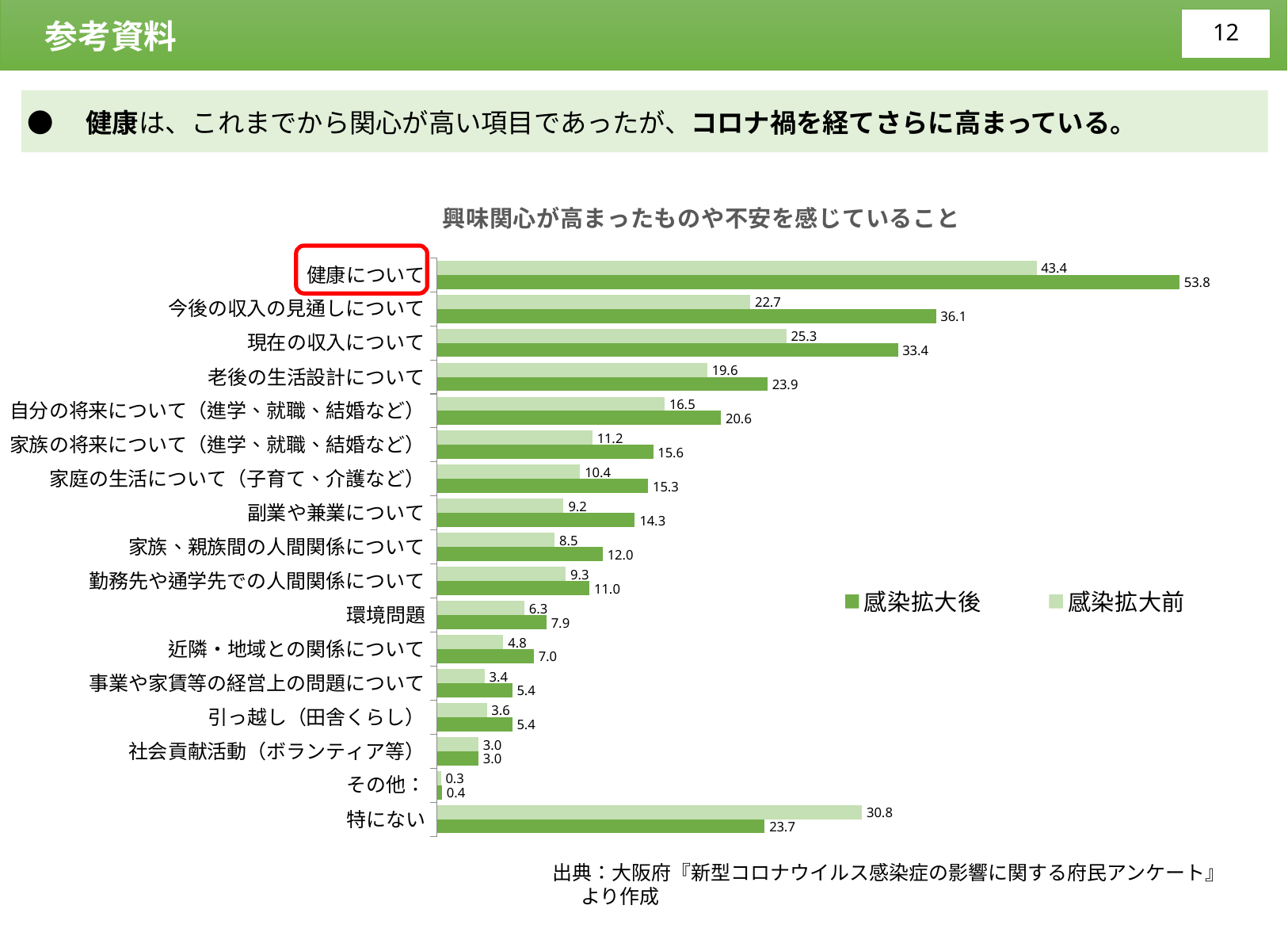
How many categories are shown on the chart? 17 What is the value for 特にない in the 感染拡大前 series? 30.8 What is the title of the chart? 興味関心が高まったものや不安を感じていること For 現在の収入について, which series has the larger value, 感染拡大後 or 感染拡大前? 感染拡大後 Which category has the highest value in the 感染拡大後 series? 健康について What is the difference between the 感染拡大後 and 感染拡大前 values for 今後の収入の見通しについて? 13.4 For 特にない, which series has the larger value, 感染拡大後 or 感染拡大前? 感染拡大前 How many series does the legend list? 2 What is the value for 健康について in the 感染拡大後 series? 53.8 What kind of chart is shown on the slide? Bar chart What is the value for 健康について in the 感染拡大前 series? 43.4 Which category has the lowest value in the 感染拡大前 series? その他：